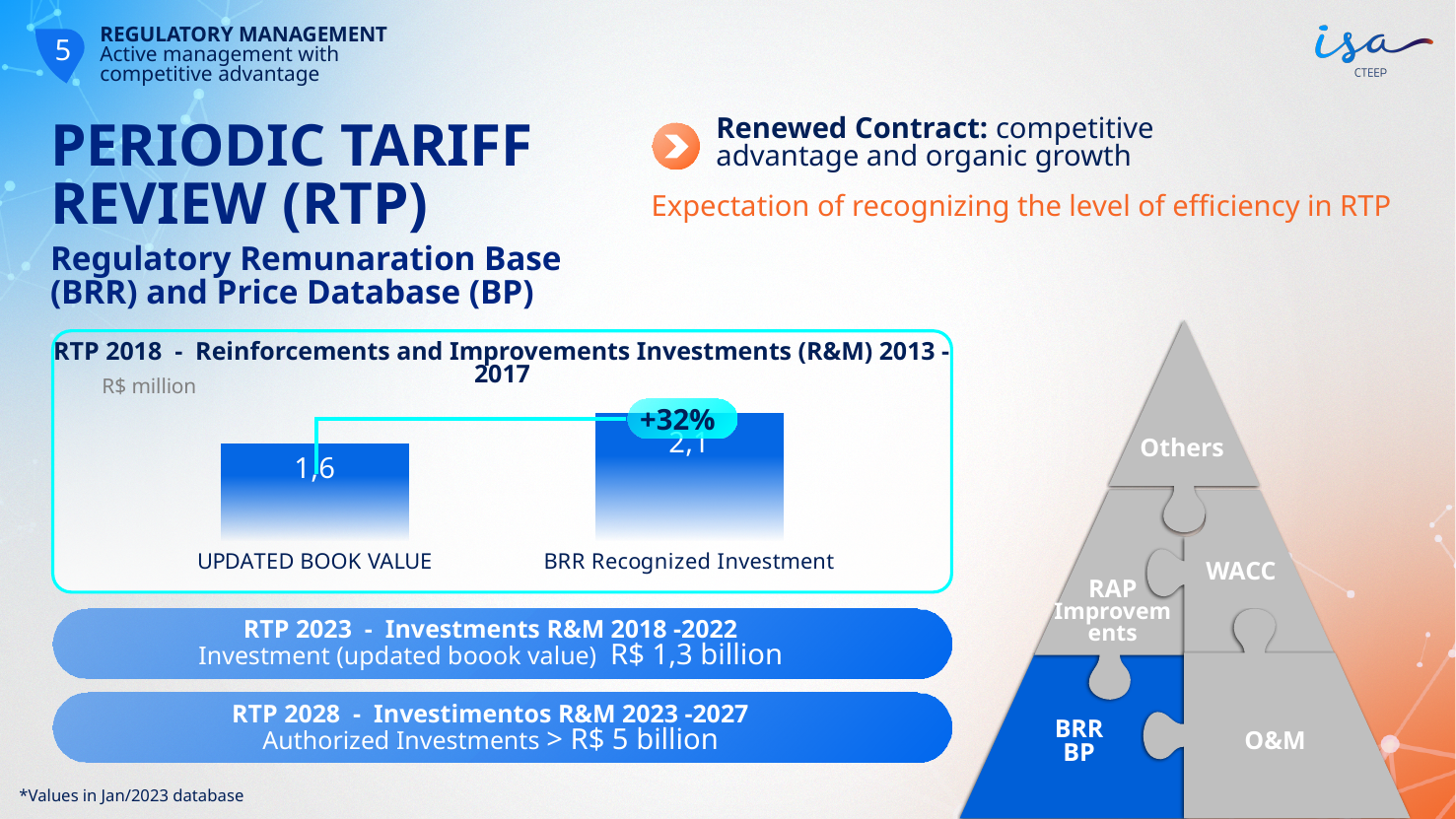
In the RTP 2018 chart, is the value for BRR Recognized Investment larger or smaller than the value for UPDATED BOOK VALUE? larger In the RTP 2018 chart, which category has the lower value? UPDATED BOOK VALUE In the RTP 2018 chart, what is the value shown for BRR Recognized Investment? 2,1 In the RTP 2018 chart, what is the value shown for UPDATED BOOK VALUE? 1,6 In the RTP 2018 chart, what is the difference between the BRR Recognized Investment value and the UPDATED BOOK VALUE value? 0,5 How many bars are plotted in the RTP 2018 chart? 2 What type of chart is shown under the title "RTP 2018 - Reinforcements and Improvements Investments (R&M) 2013 - 2017"? bar chart Do the values in the RTP 2018 chart rise or fall from the left bar to the right bar? rise What percentage increase is annotated between the two bars in the RTP 2018 chart? +32% What unit is indicated for the values in the RTP 2018 chart? R$ million In the RTP 2018 chart, which category has the higher value? BRR Recognized Investment